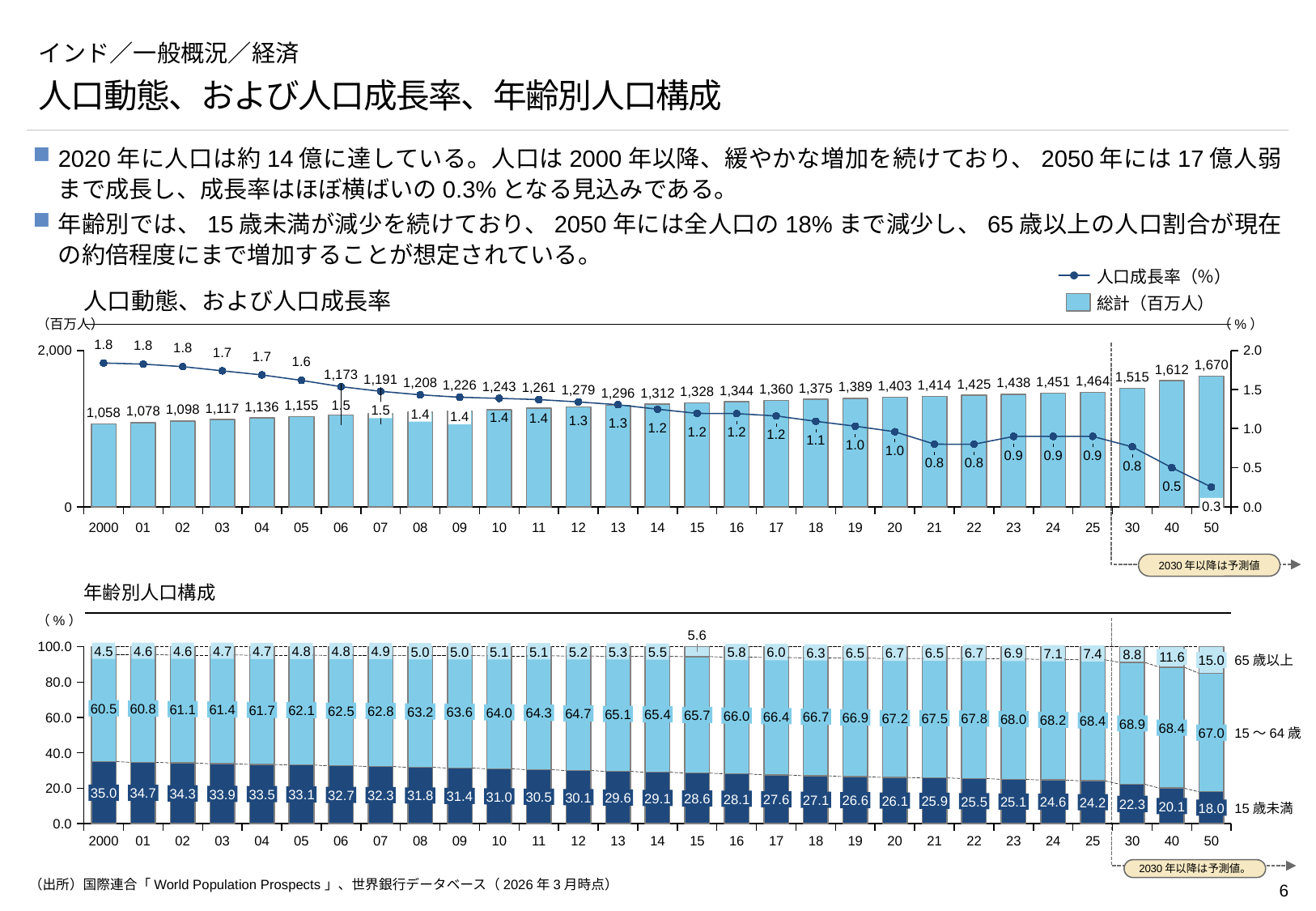
In the top chart (人口動態、および人口成長率), what is the 総計 (百万人) value for 2020? 1,403 What kind of chart is the bottom chart (年齢別人口構成)? stacked bar chart How many years are shown on the x axis of the top chart (人口動態、および人口成長率)? 29 In the bottom chart (年齢別人口構成), what is the 15歳未満 value for 2000? 35.0 How many series does the legend of the top chart (人口動態、および人口成長率) list? 2 In the bottom chart (年齢別人口構成), what is the 65歳以上 value for 2050? 15.0 In the top chart (人口動態、および人口成長率), which year has the highest 総計 bar? 2050 In the top chart (人口動態、および人口成長率), does the 人口成長率 line generally rise or fall from 2000 to 2050? fall In the bottom chart (年齢別人口構成), what is the total of the stacked bar for 2050? 100.0 In the top chart (人口動態、および人口成長率), what is the difference between the 総計 values for 2050 and 2000? 612 In the top chart (人口動態、および人口成長率), what is the 人口成長率 (%) value for 2050? 0.3 In the bottom chart (年齢別人口構成), which year has the larger 15歳未満 value, 2000 or 2050? 2000